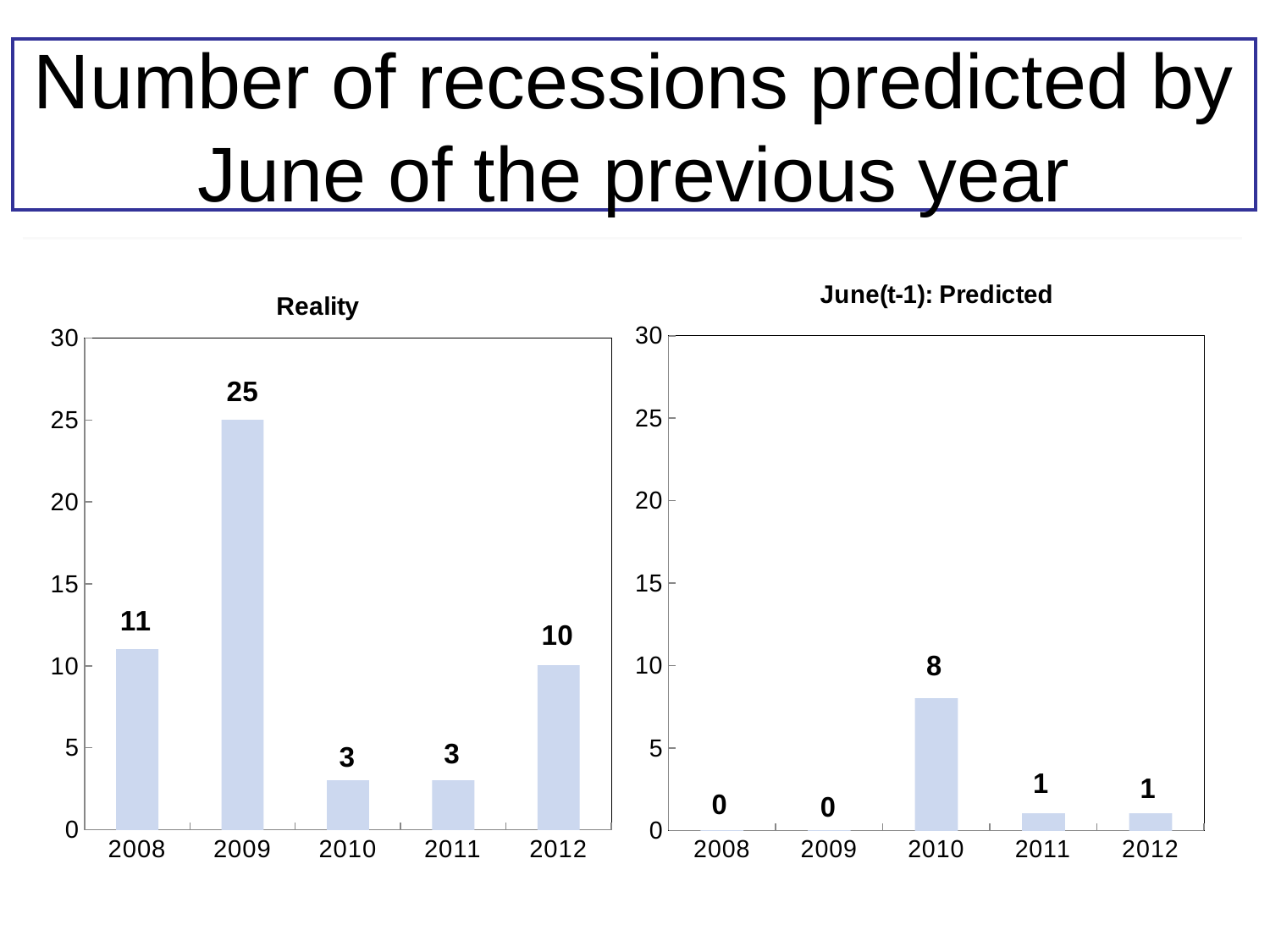
In the "Reality" chart, which year has the highest value? 2009 How many years are shown on the x axis of the "June(t-1): Predicted" chart? 5 What is the title of the chart on the right side of the slide? June(t-1): Predicted In the "Reality" chart, what is the difference between the values for 2009 and 2008? 14 In the "June(t-1): Predicted" chart, what is the difference between the values for 2010 and 2011? 7 In the "June(t-1): Predicted" chart, which year has the highest value? 2010 What kind of chart is the "Reality" chart? bar chart In the "Reality" chart, what is the value for 2009? 25 In the "Reality" chart, is the value for 2009 greater or less than 20? greater In the "Reality" chart, which is larger, the value for 2008 or the value for 2012? 2008 In the "June(t-1): Predicted" chart, what is the value for 2012? 1 In the "June(t-1): Predicted" chart, what is the value for 2010? 8